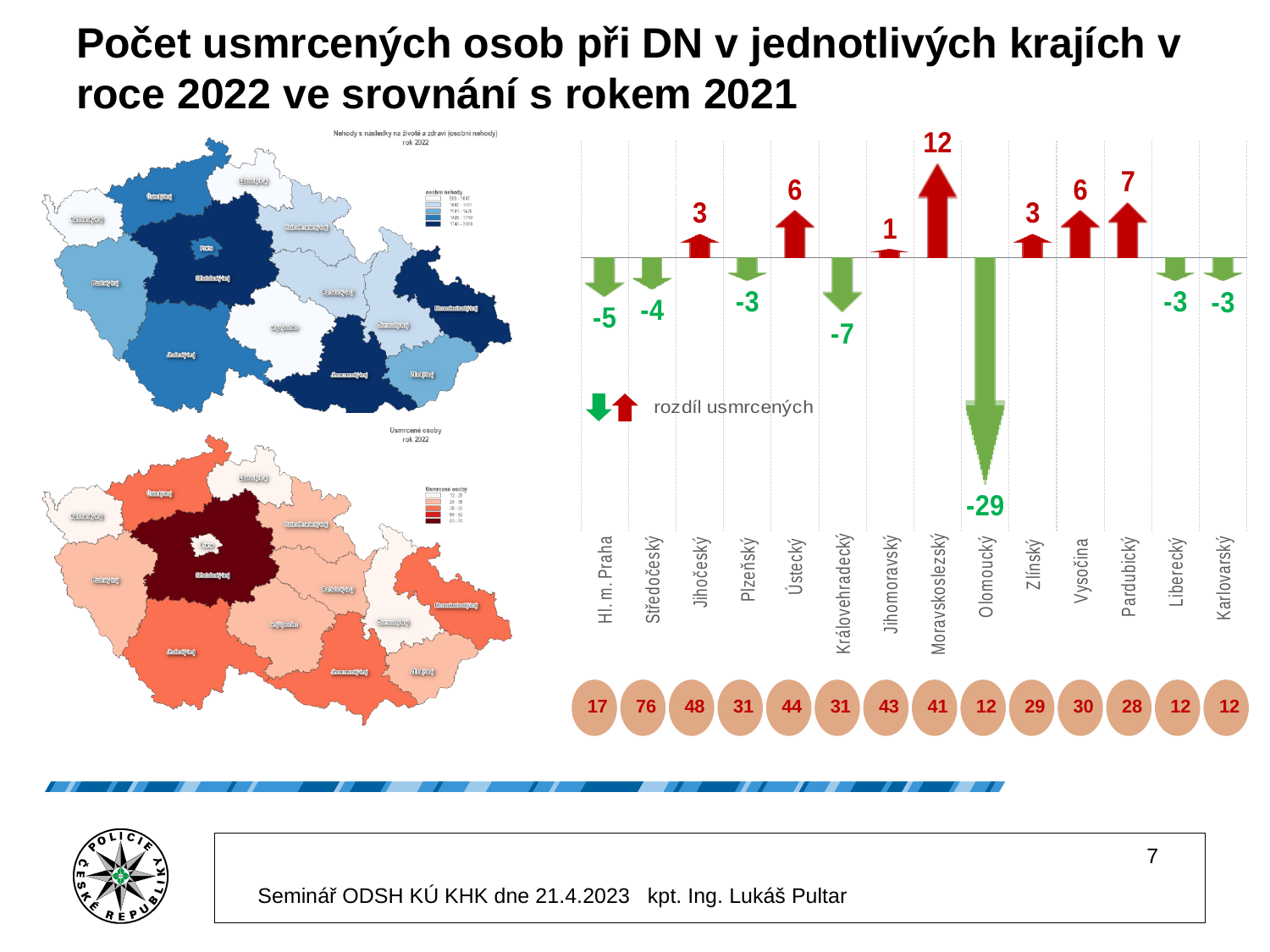
How many series does the legend of the arrow chart on the right list? 1 How many regions are shown on the x axis of the arrow chart on the right? 14 In the arrow chart on the right, what is the value shown for Moravskoslezský? 12 In the arrow chart on the right, which region has the highest value? Moravskoslezský In the arrow chart on the right, what is the difference between the values for Moravskoslezský and Pardubický? 5 In the arrow chart on the right, what is the value shown for Pardubický? 7 In the arrow chart on the right, what is the difference between the values for Ústecký and Plzeňský? 9 What is the legend entry of the arrow chart on the right? rozdíl usmrcených In the arrow chart on the right, which has the larger value, Vysočina or Zlínský? Vysočina In the arrow chart on the right, which region has the lowest value? Olomoucký In the arrow chart on the right, what is the value shown for Královehradecký? -7 In the arrow chart on the right, what is the value shown for Olomoucký? -29